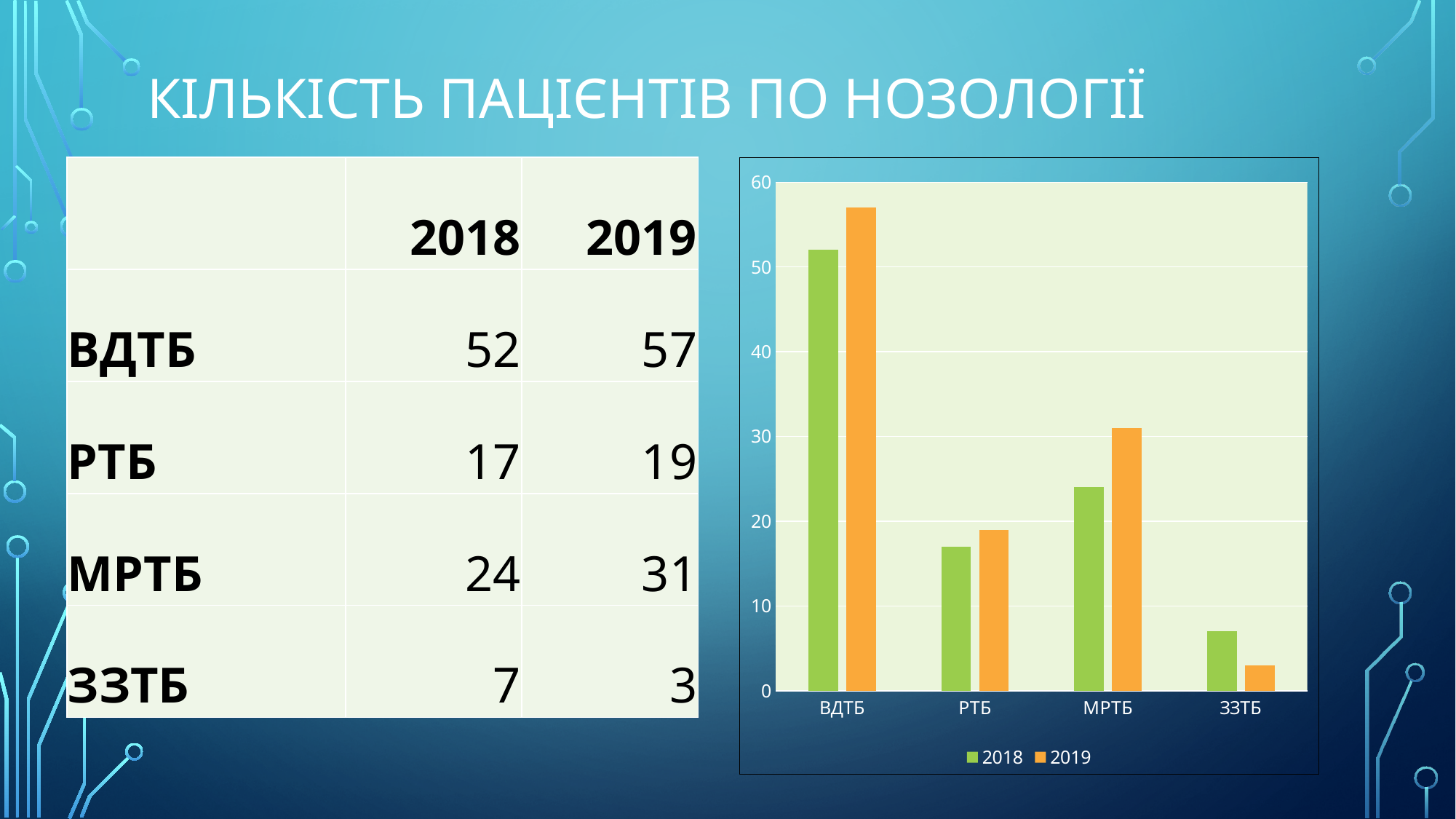
Which category has the lowest value in the 2018 series? ЗЗТБ How many categories are shown on the x axis of the chart? 4 Which category has the highest value in the 2019 series? ВДТБ What is the value for ЗЗТБ in 2019? 3 What is the difference between the 2019 and 2018 values for МРТБ? 7 Is the value for РТБ in 2018 greater or less than 20? less What is the value for МРТБ in 2018? 24 Which colour represents the 2019 series in the chart? orange Which is larger for ЗЗТБ, the 2018 value or the 2019 value? 2018 What type of chart is shown on the slide? bar chart What is the value for ВДТБ in 2019? 57 How many series does the chart legend list? 2